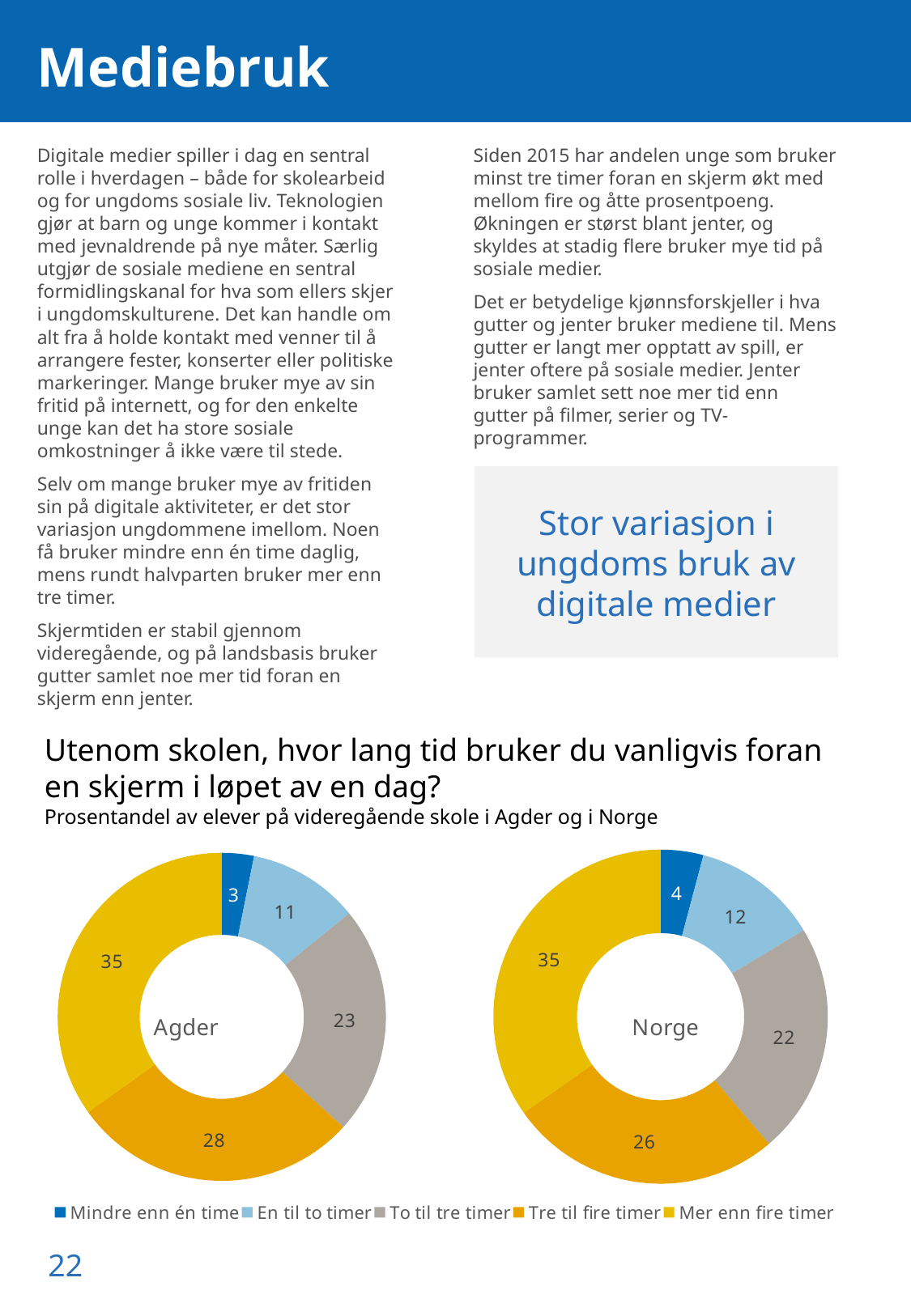
How many categories does each donut chart show? 5 In the Norge chart, which category has the largest share? Mer enn fire timer In the Norge chart, what is the value for "En til to timer"? 12 Which colour represents "Mindre enn én time" in the legend? Dark blue Which is larger: "To til tre timer" in the Agder chart or "To til tre timer" in the Norge chart? Agder In the Agder chart, what percentage of students chose "Mer enn fire timer"? 35 In the Norge chart, what percentage of students chose "To til tre timer"? 22 In the Agder chart, what is the combined share of "Tre til fire timer" and "Mer enn fire timer"? 63 In the Agder chart, what is the value for "Mindre enn én time"? 3 What is the difference between the "Tre til fire timer" values in the Agder chart and the Norge chart? 2 In the Agder chart, which category has the smallest share? Mindre enn én time What type of chart is used to show the Agder and Norge data? Donut (pie) chart